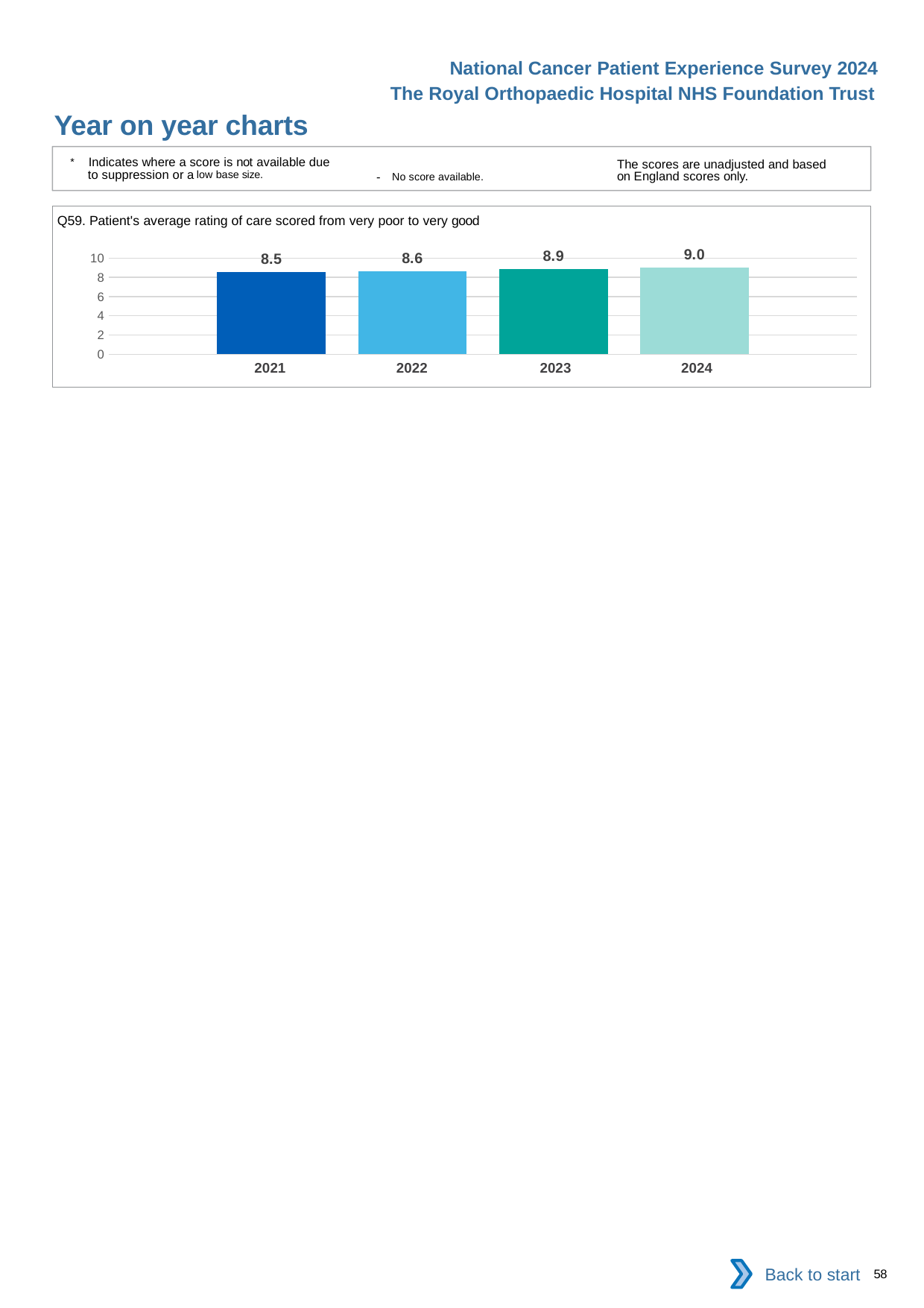
What kind of chart is shown? bar chart What is the difference between the values for 2024 and 2021? 0.5 How many years are shown on the chart? 4 Do the values rise or fall from 2021 to 2024? rise What is the value for 2023? 8.9 What is the value for 2021? 8.5 Which year has the highest value? 2024 Which year has the lowest value? 2021 What is the value for 2024? 9.0 Is the value for 2022 greater or less than 6? greater What is the title of the chart? Q59. Patient's average rating of care scored from very poor to very good Which is larger, the value for 2022 or the value for 2023? 2023